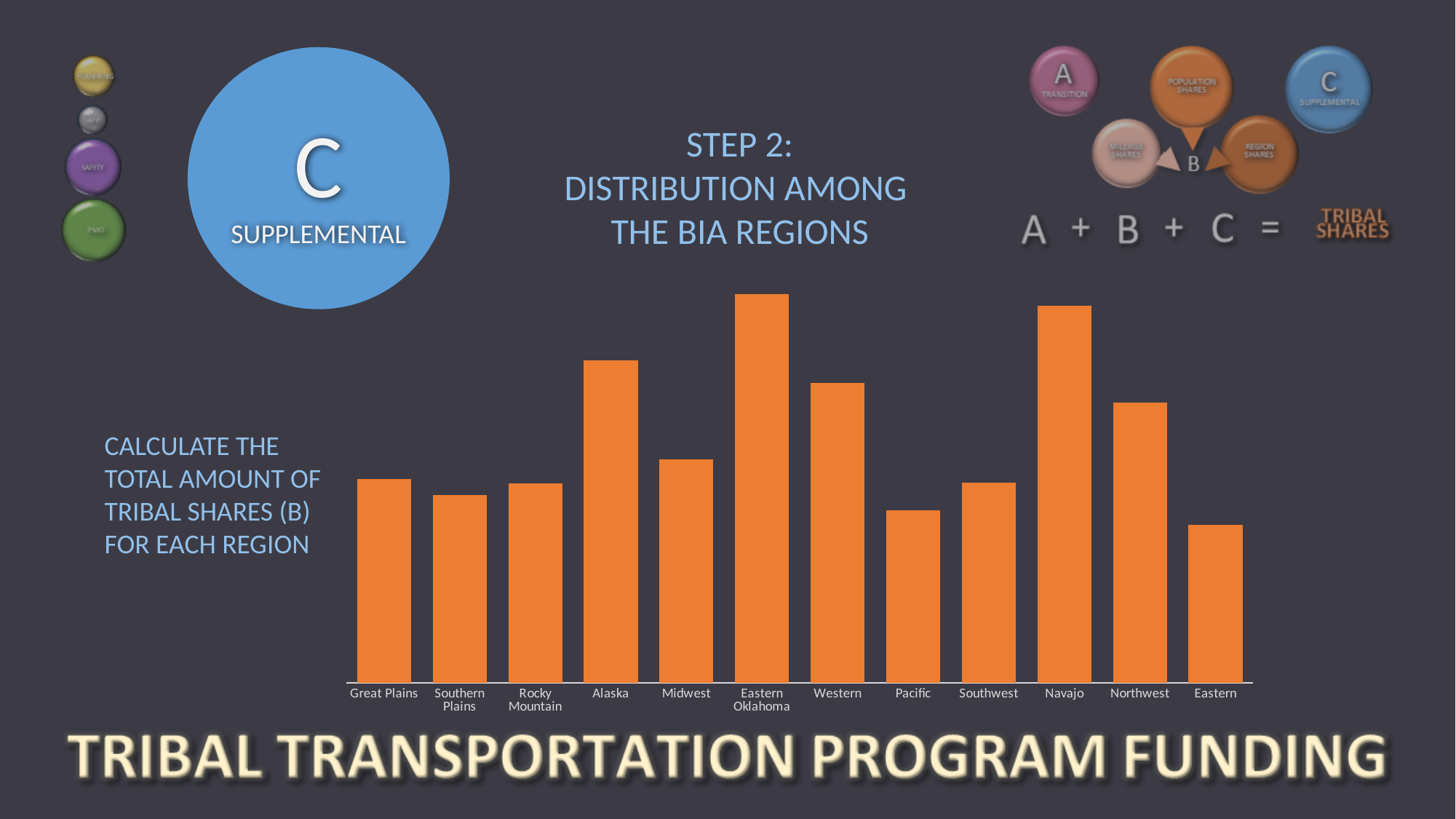
Which bar is taller, Midwest or Great Plains? Midwest Which region has the shortest bar in the chart? Eastern How many BIA regions are shown on the x axis of the bar chart? 12 Which bar is taller, Eastern or Pacific? Pacific Which region has the tallest bar in the chart? Eastern Oklahoma What colour are the bars in the chart? orange Which bar is taller, Navajo or Northwest? Navajo What kind of chart is shown on the slide? bar chart Which region's label appears first on the left of the x axis? Great Plains Which region has the second tallest bar in the chart? Navajo